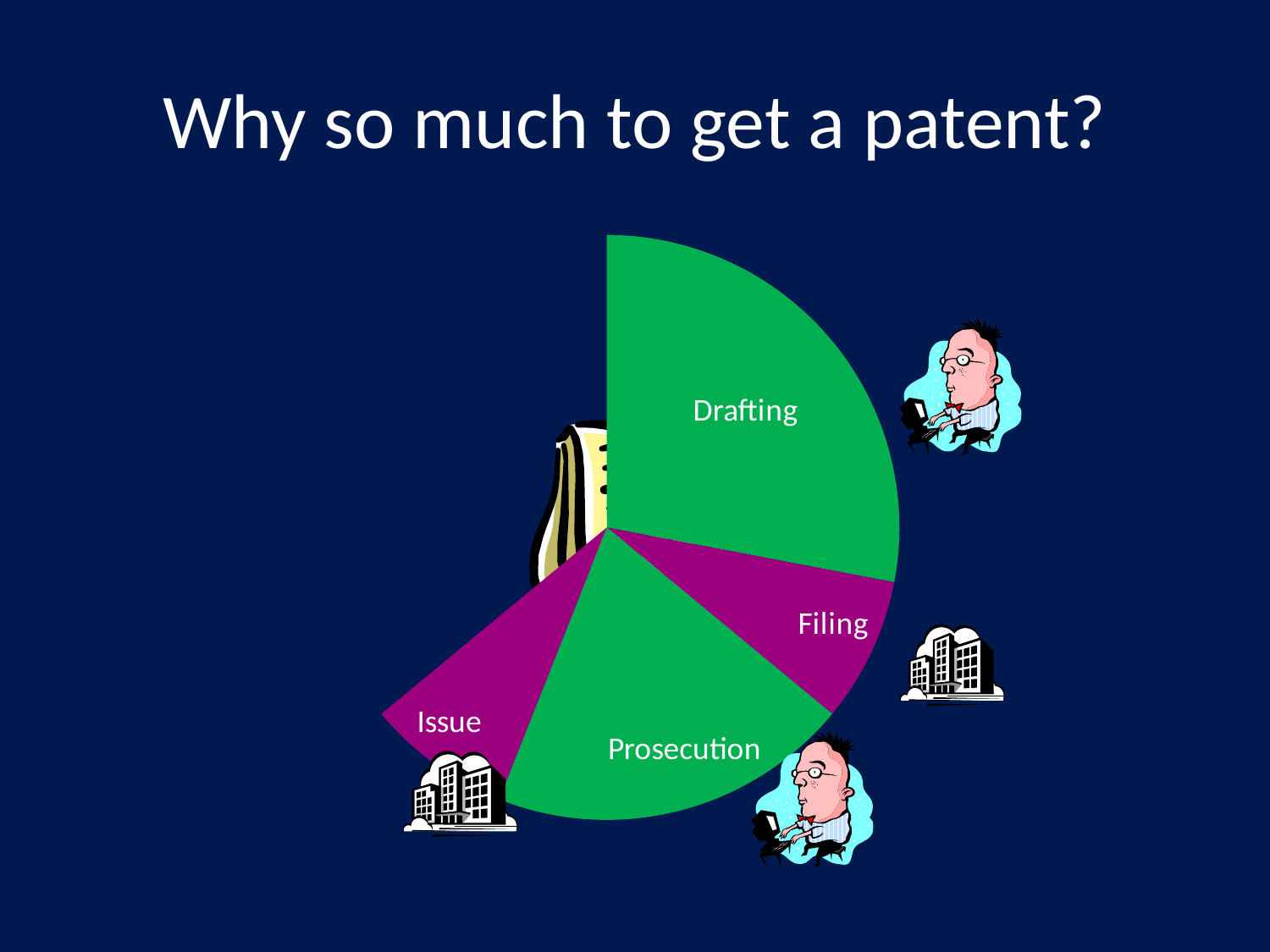
Which slice is larger, Drafting or Filing? Drafting How many labelled slices does the pie chart have? 4 Which slice is larger, Drafting or Prosecution? Drafting Which slice is larger, Prosecution or Filing? Prosecution What kind of chart is shown on the slide? pie chart Which slice of the pie chart is the largest? Drafting What colour are the Filing and Issue slices of the pie chart? purple What is the title of the slide containing the pie chart? Why so much to get a patent?